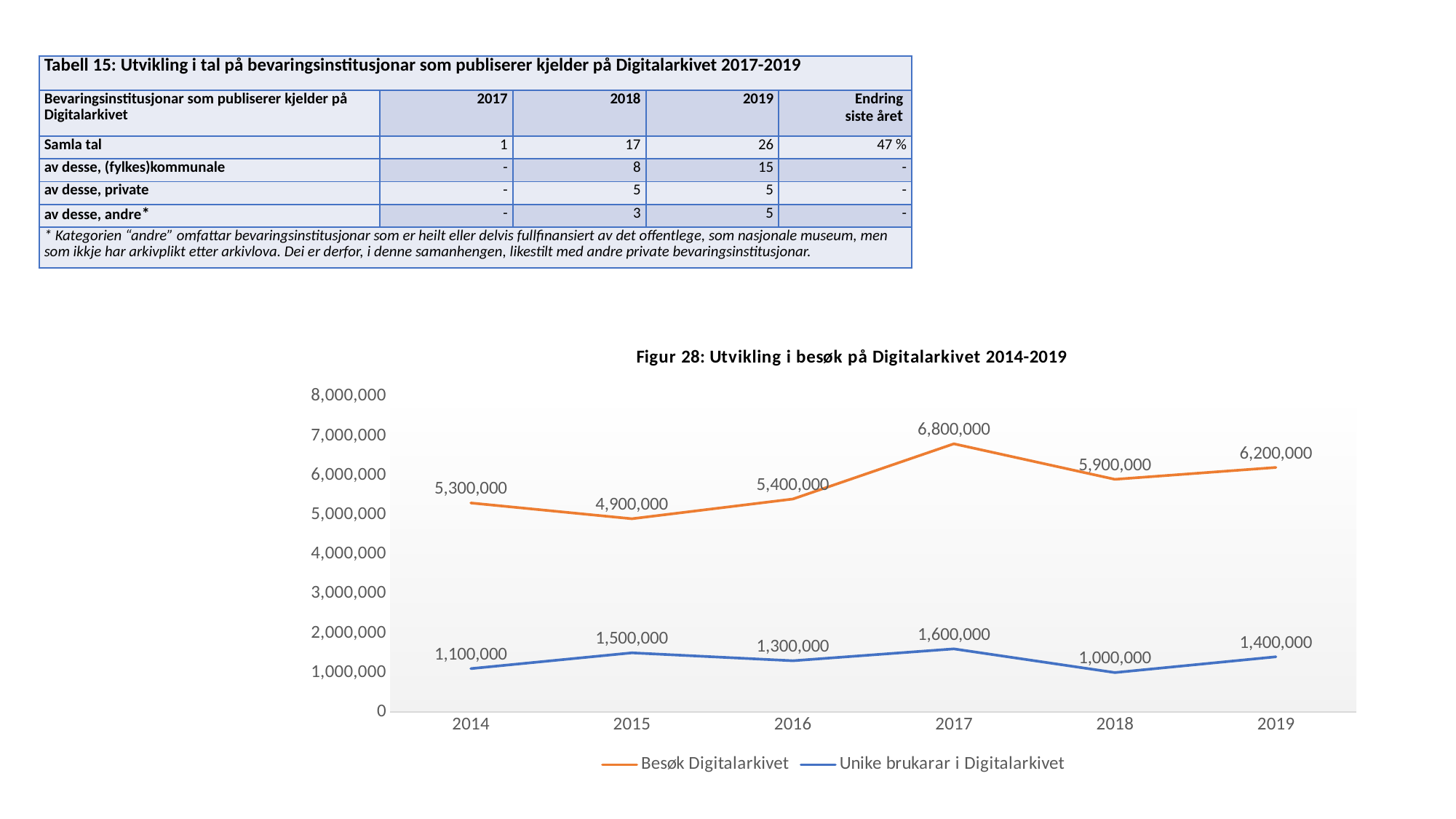
What is the title of the chart on the slide? Figur 28: Utvikling i besøk på Digitalarkivet 2014-2019 In Figur 28, which year has the highest value for Besøk Digitalarkivet? 2017 What type of chart is Figur 28? line chart In Figur 28, what is the difference between Besøk Digitalarkivet in 2017 and in 2018? 900,000 In Figur 28, which is larger: Unike brukarar i Digitalarkivet in 2015 or in 2016? 2015 In Figur 28, what is the value for Besøk Digitalarkivet in 2017? 6,800,000 In Figur 28, what is the value for Unike brukarar i Digitalarkivet in 2018? 1,000,000 How many years are shown on the x axis of Figur 28? 6 In Figur 28, which year has the lowest value for Unike brukarar i Digitalarkivet? 2018 How many series does the legend of Figur 28 list? 2 In Figur 28, is the value for Besøk Digitalarkivet in 2015 greater or less than 5,000,000? less In Figur 28, does Besøk Digitalarkivet rise or fall from 2018 to 2019? rise